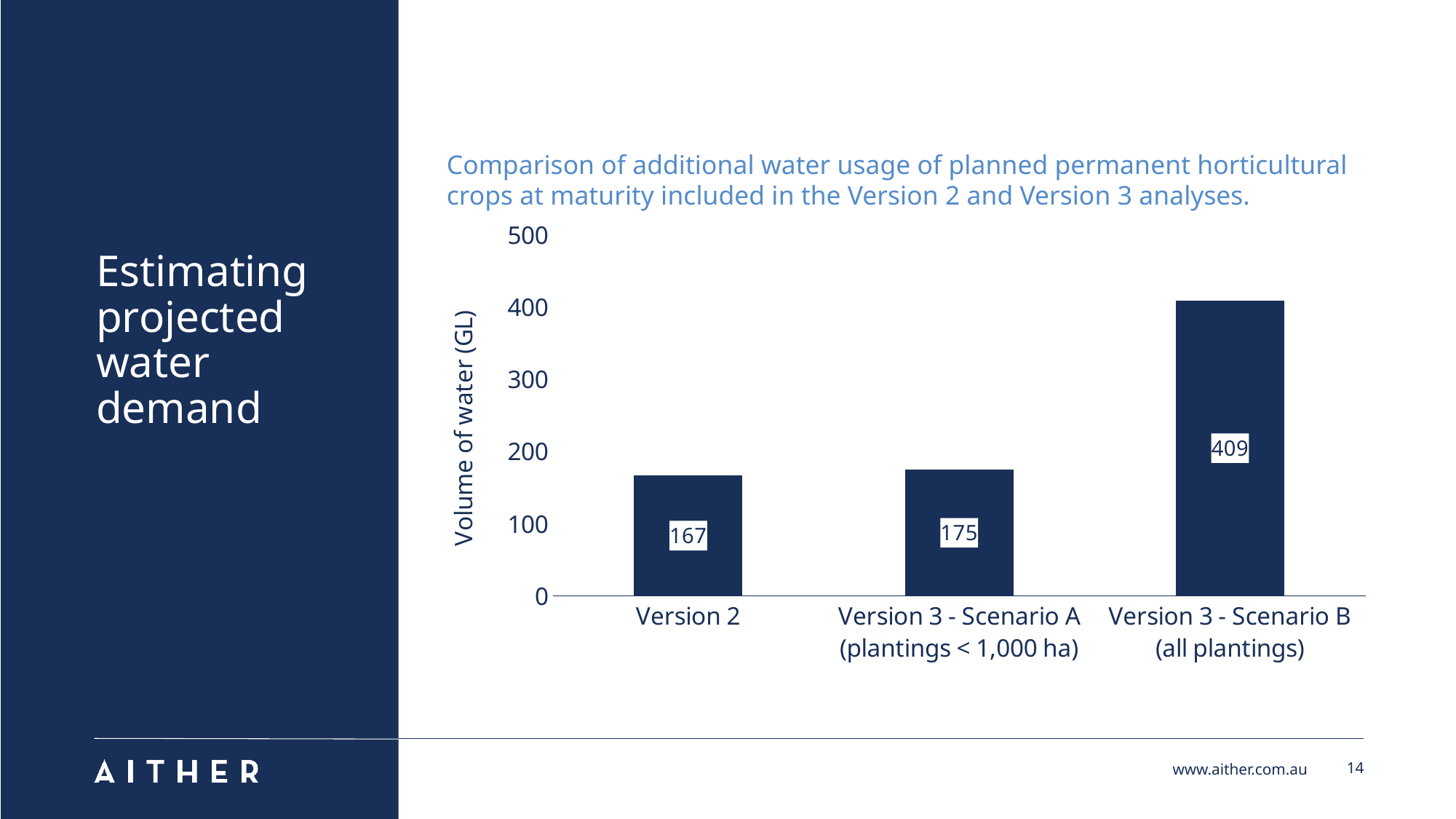
What is the volume of water for Version 3 - Scenario B (all plantings)? 409 How many categories are shown on the chart? 3 Which is larger, the value for Version 3 - Scenario B or the value for Version 3 - Scenario A? Version 3 - Scenario B What is the difference in volume of water between Version 3 - Scenario B and Version 2? 242 Which category has the highest volume of water? Version 3 - Scenario B (all plantings) What kind of chart is shown on the slide? Bar chart What is the label of the vertical axis? Volume of water (GL) Is the value for Version 3 - Scenario B greater or less than 400? greater What is the difference in volume of water between Version 3 - Scenario A and Version 2? 8 What is the volume of water for Version 3 - Scenario A (plantings < 1,000 ha)? 175 What is the volume of water for Version 2? 167 Which category has the lowest volume of water? Version 2